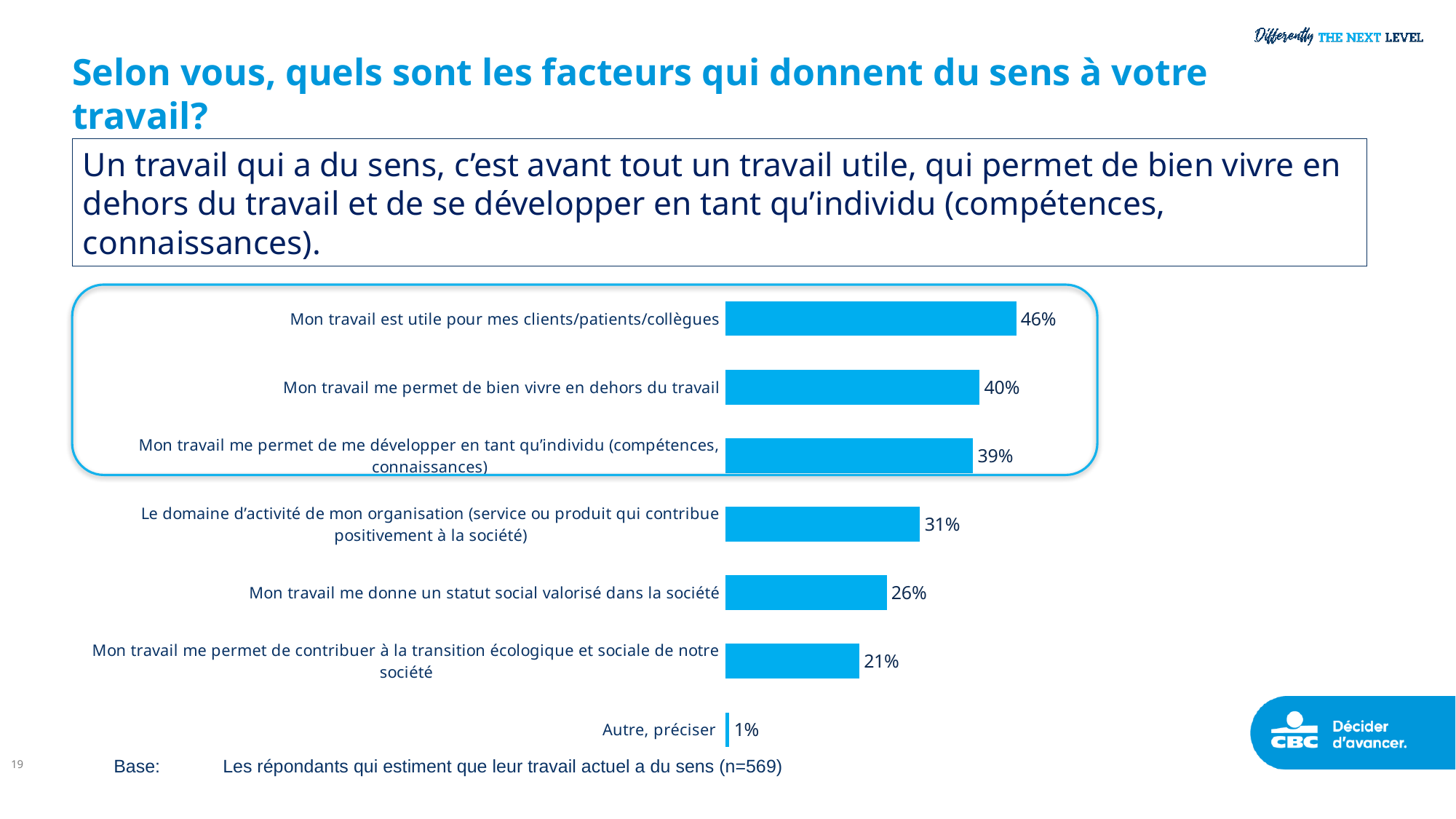
Which factor has the highest percentage? Mon travail est utile pour mes clients/patients/collègues What is the difference between the highest and the second-highest values in the chart? 6 percentage points Which is larger: the value for "Le domaine d'activité de mon organisation" or the value for "Mon travail me donne un statut social valorisé dans la société"? Le domaine d'activité de mon organisation What is the value for "Autre, préciser"? 1% How many categories are shown in the chart? 7 What is the value for "Mon travail me donne un statut social valorisé dans la société"? 26% What percentage of respondents chose "Mon travail est utile pour mes clients/patients/collègues"? 46% What is the value for "Mon travail me permet de me développer en tant qu'individu (compétences, connaissances)"? 39% What kind of chart is shown on the slide? Bar chart How many of the top factors are enclosed in the rounded outline box on the chart? 3 Which factor has the lowest percentage? Autre, préciser What is the difference between "Mon travail me permet de bien vivre en dehors du travail" and "Mon travail me permet de contribuer à la transition écologique et sociale de notre société"? 19 percentage points